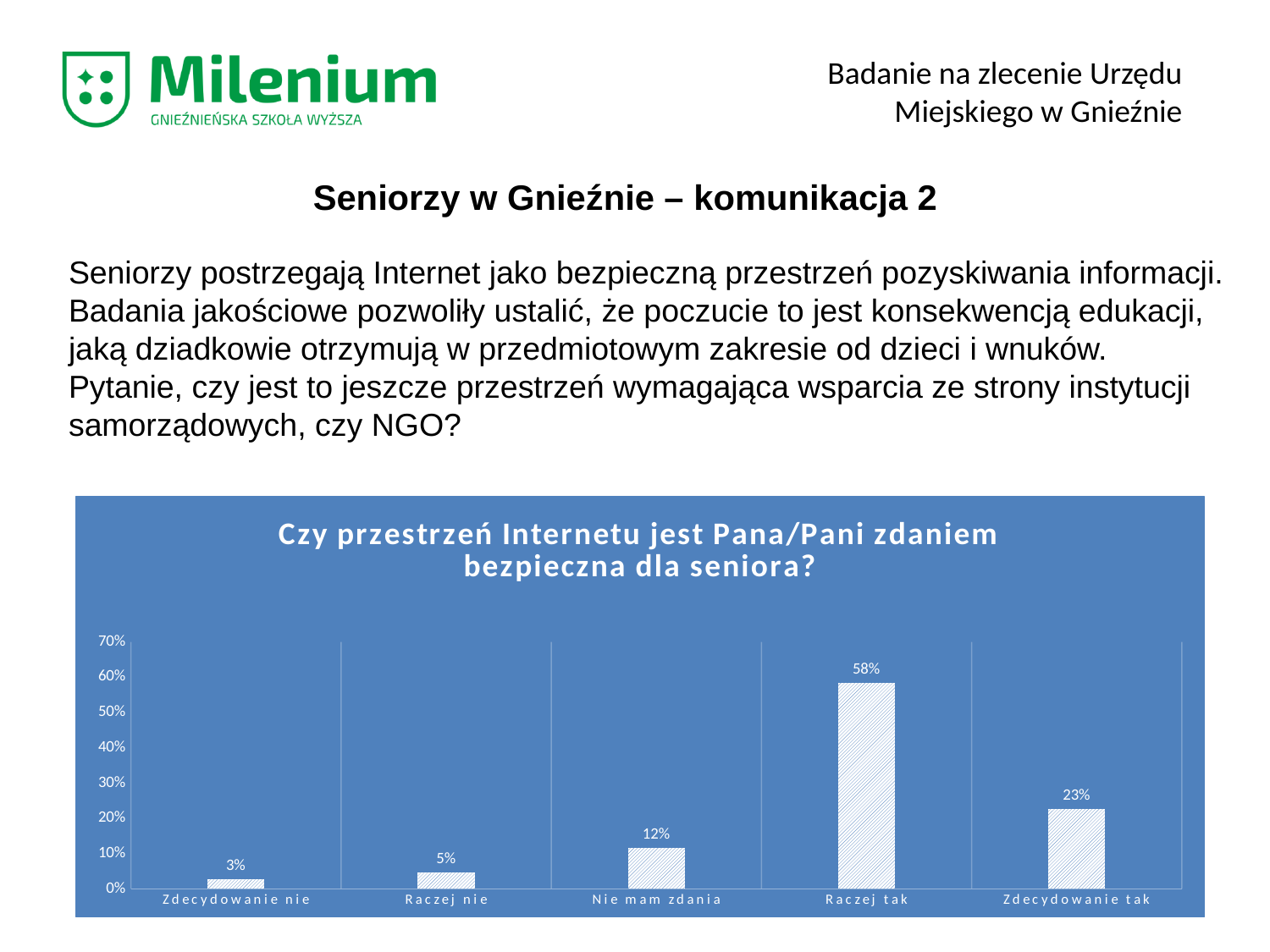
What is the value for "Zdecydowanie tak"? 23% What is the value for "Zdecydowanie nie"? 3% Which category has the lowest value? Zdecydowanie nie What kind of chart is shown on the slide? bar chart Which is larger, the value for "Raczej nie" or the value for "Nie mam zdania"? Nie mam zdania How many categories are shown on the x axis? 5 Which category has the highest value? Raczej tak Is the value for "Zdecydowanie tak" greater or less than 30%? less What is the value for "Nie mam zdania"? 12% What is the difference between the values for "Raczej tak" and "Zdecydowanie tak"? 35% What is the title of the chart? Czy przestrzeń Internetu jest Pana/Pani zdaniem bezpieczna dla seniora? What is the value for "Raczej tak"? 58%